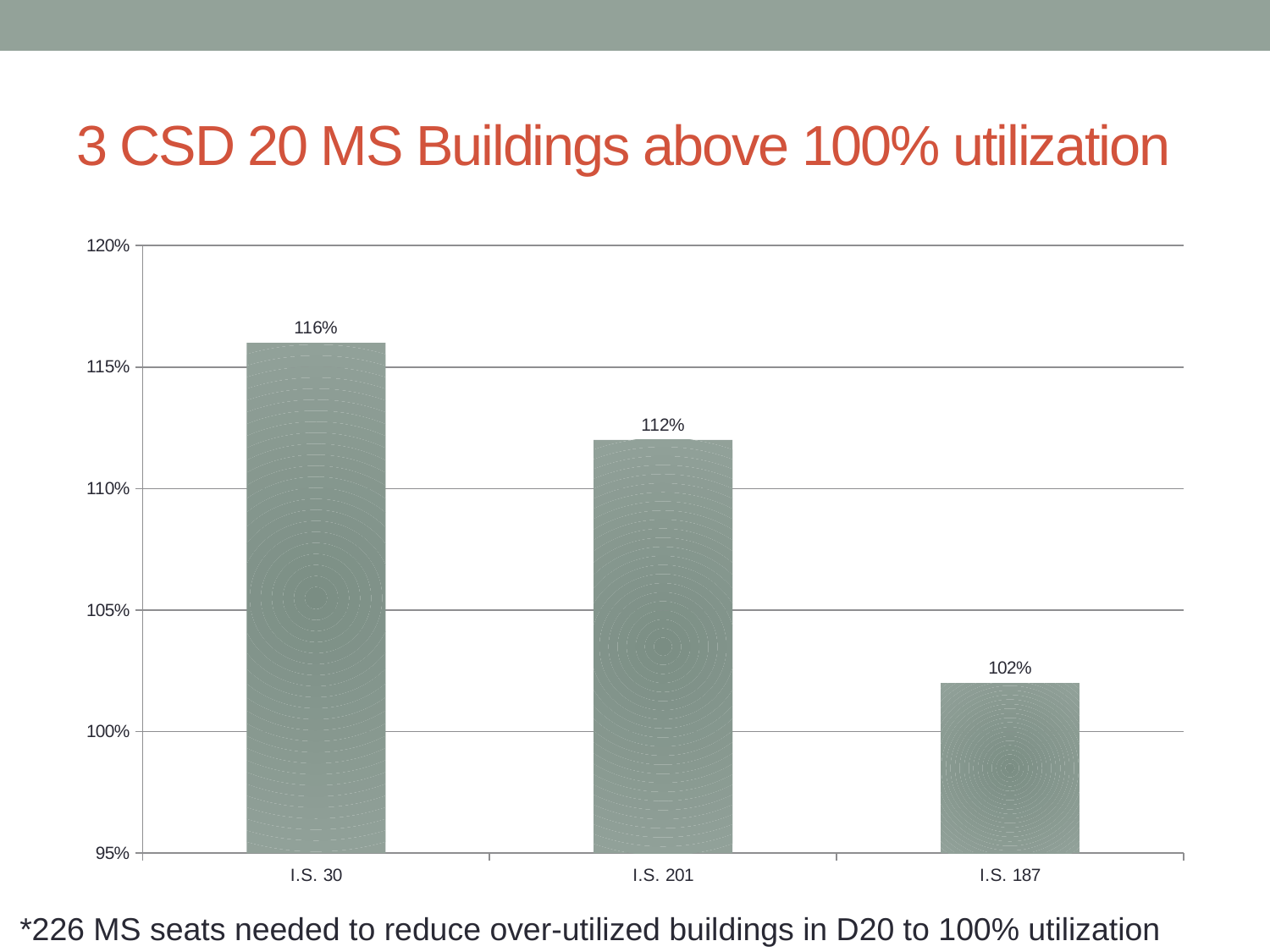
What is the difference in utilization between I.S. 30 and I.S. 187? 14% What is the utilization value for I.S. 30? 116% How many buildings are shown in the chart? 3 What is the utilization value for I.S. 201? 112% What kind of chart is shown on the slide? Bar chart Which has a higher utilization, I.S. 201 or I.S. 187? I.S. 201 What is the difference in utilization between I.S. 201 and I.S. 187? 10% Is the value for I.S. 201 greater or less than 110%? greater What is the utilization value for I.S. 187? 102% Which building has the lowest utilization? I.S. 187 Which building has the highest utilization? I.S. 30 Do the values rise or fall from left to right across the chart? Fall